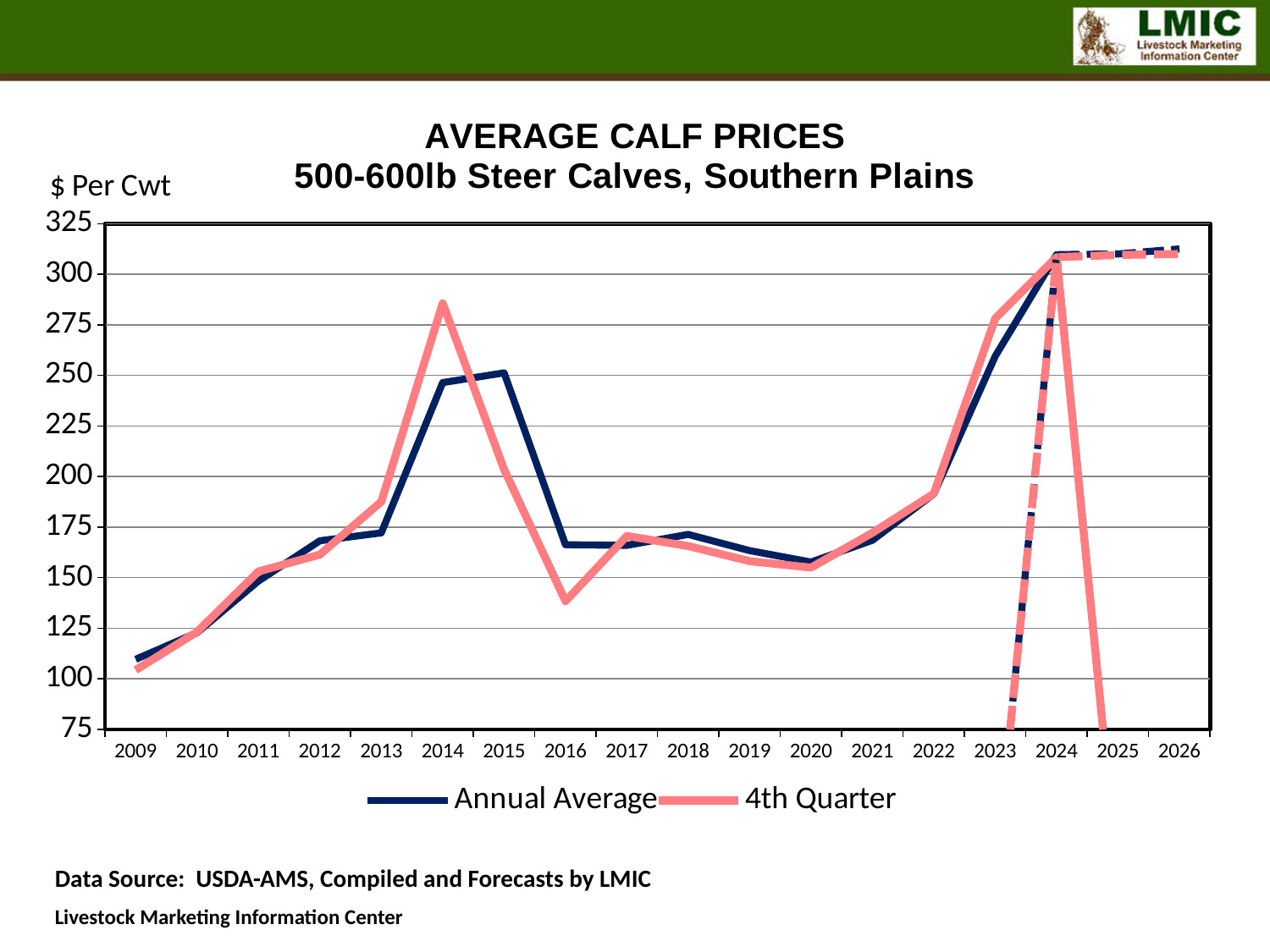
Is the Annual Average value for 2016 greater or less than 175? less What kind of chart is shown on the slide? Line chart Is the 4th Quarter value for 2014 greater or less than 275? greater Between 2009 and 2020, in which year is the 4th Quarter value highest? 2014 In which year is the 4th Quarter value lowest? 2009 Does the Annual Average line rise or fall from 2020 to 2024? Rise Is the 4th Quarter value for 2016 greater or less than 150? less In 2014, which series has the larger value, Annual Average or 4th Quarter? 4th Quarter How many series does the legend list? 2 In 2015, which series has the larger value, Annual Average or 4th Quarter? Annual Average In which year is the Annual Average value lowest? 2009 How many years are shown on the x axis? 18